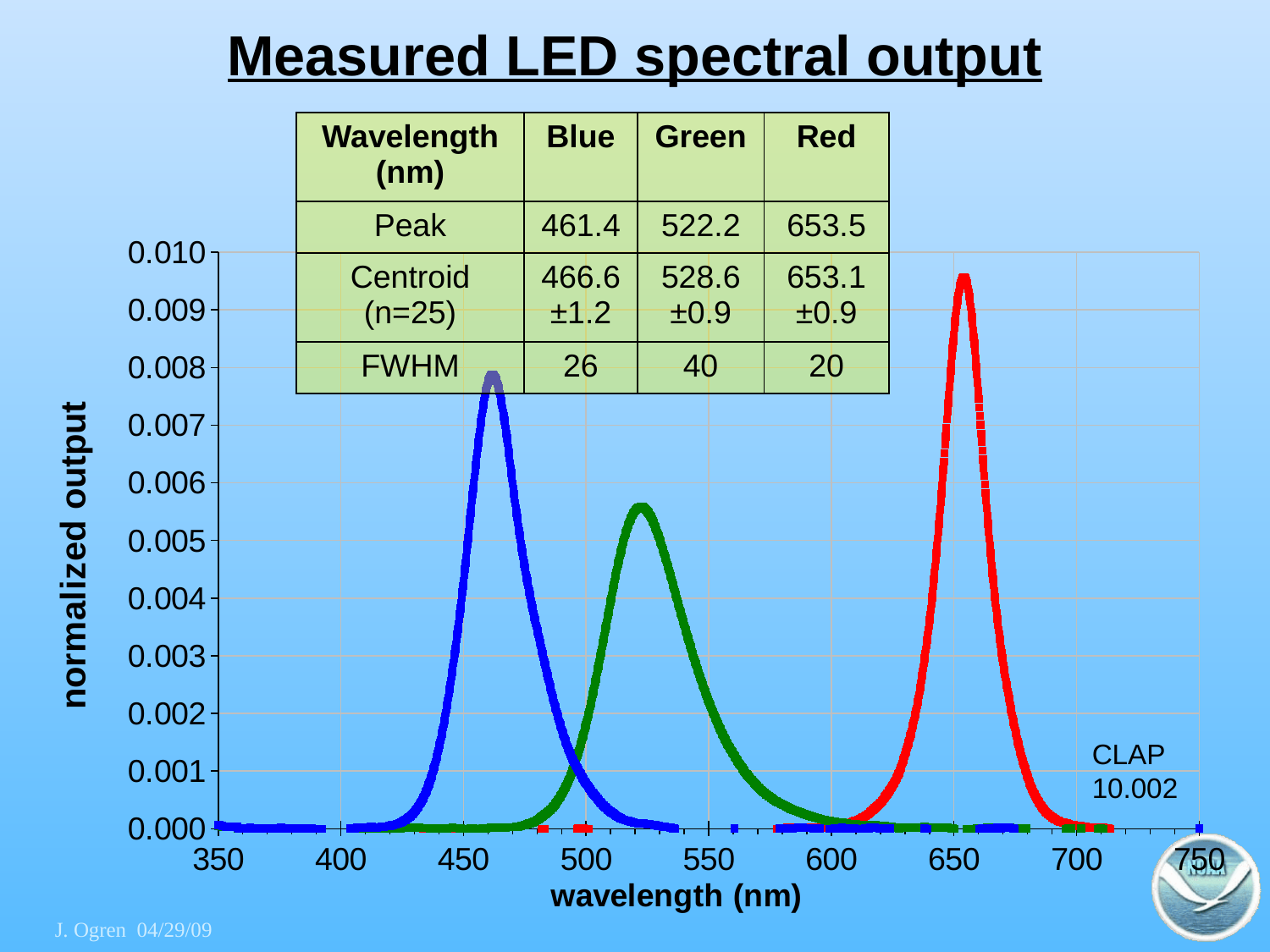
Which LED curve has the lowest peak normalized output? Green Is the peak normalized output of the green LED greater or less than 0.005? greater How many LED spectral curves are plotted on the chart? 3 According to the table on the chart, what is the peak wavelength of the green LED in nm? 522.2 What is the label of the x axis of the chart? wavelength (nm) Which curve has a higher peak normalized output, the blue LED or the green LED? Blue Using the peak wavelengths in the table, what is the difference between the red and blue LED peak wavelengths in nm? 192.1 Which LED curve reaches the highest normalized output? Red Is the peak normalized output of the blue LED greater or less than 0.007? greater According to the table on the chart, what is the FWHM of the blue LED? 26 What kind of chart is shown on the slide? line chart Is the peak normalized output of the red LED greater or less than 0.009? greater